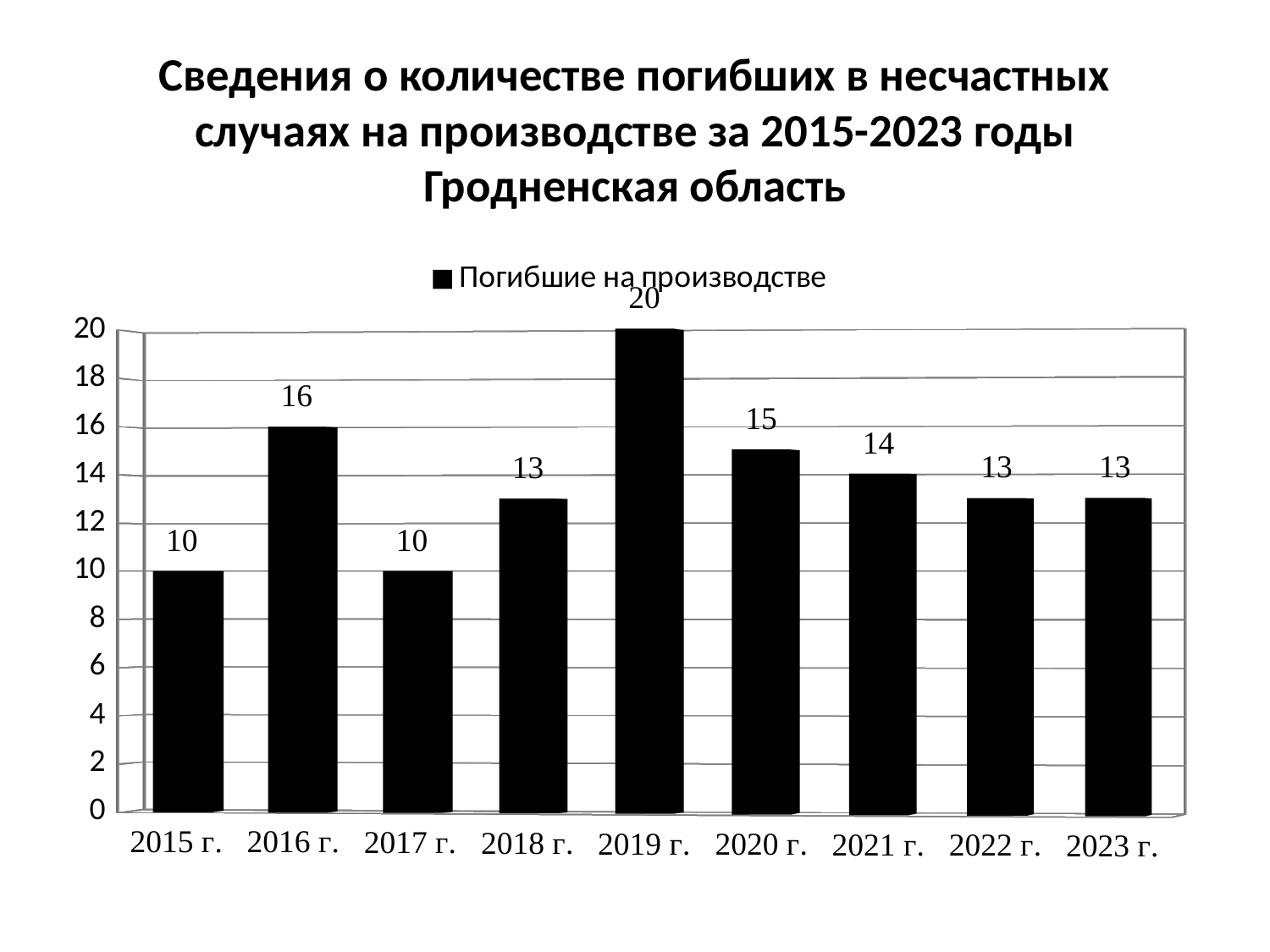
What is the value for 2019 г.? 20 What is the difference between the values for 2019 г. and 2015 г.? 10 How many series does the legend list? 1 What kind of chart is shown on the slide? bar chart Is the value for 2019 г. greater or less than 18? greater Which is larger, the value for 2020 г. or the value for 2022 г.? 2020 г. What is the legend entry of the series shown? Погибшие на производстве What is the value for 2021 г.? 14 Which year has the highest value? 2019 г. What is the value for 2016 г.? 16 How many years are shown on the x axis? 9 What is the difference between the values for 2016 г. and 2018 г.? 3